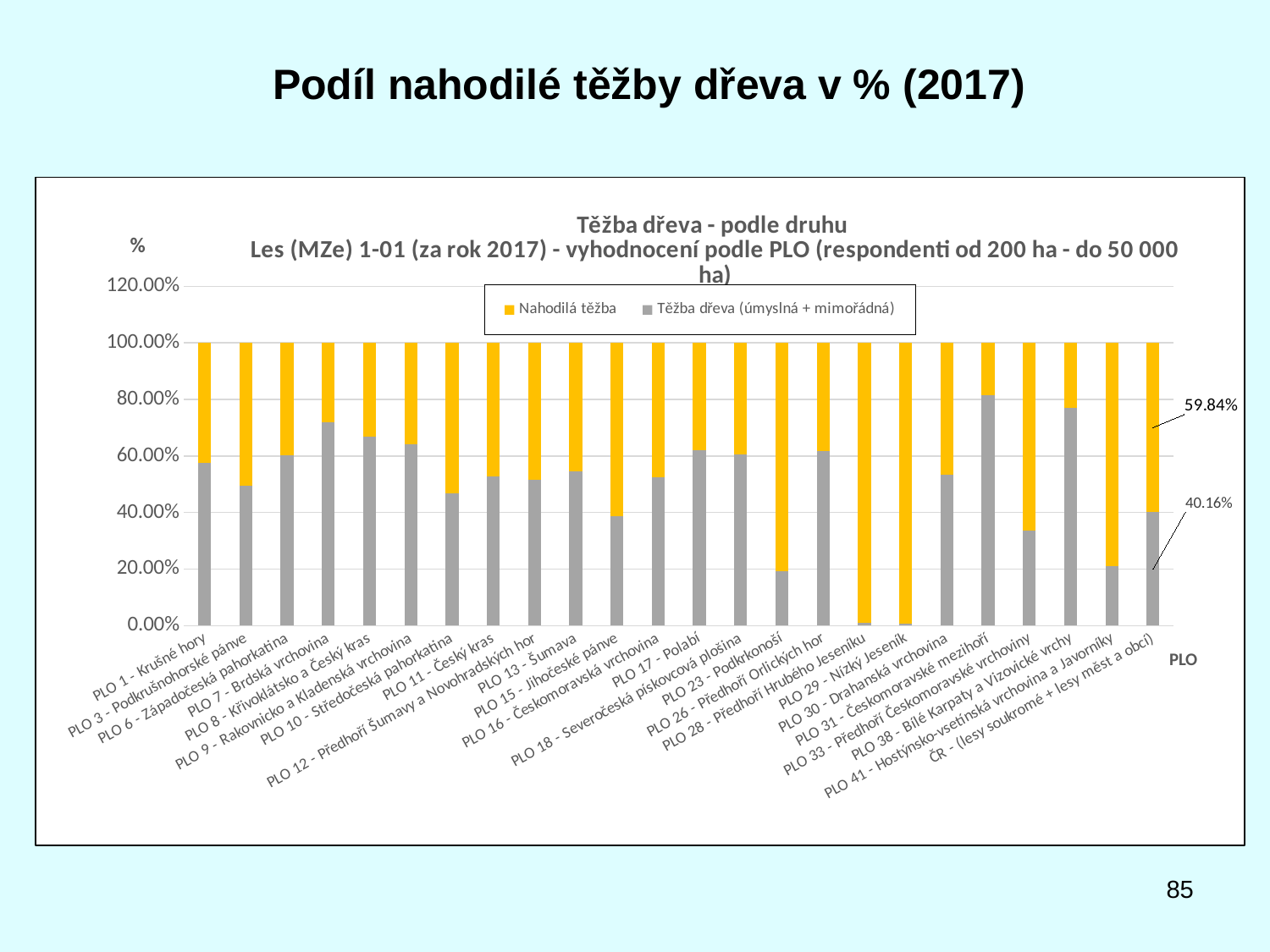
Which has the larger Těžba dřeva (úmyslná + mimořádná) share: PLO 7 - Brdská vrchovina or PLO 38 - Bílé Karpaty a Vizovické vrchy? PLO 38 - Bílé Karpaty a Vizovické vrchy Is the Nahodilá těžba share for PLO 29 - Nízký Jeseník greater or less than 80.00%? greater What is the value of Těžba dřeva (úmyslná + mimořádná) for ČR - (lesy soukromé + lesy měst a obcí)? 40.16% What is the title shown at the top of the slide? Podíl nahodilé těžby dřeva v % (2017) What type of chart is shown on the slide? stacked bar chart How many series does the chart legend list? 2 What is the value of Nahodilá těžba for ČR - (lesy soukromé + lesy měst a obcí)? 59.84% Is the Těžba dřeva (úmyslná + mimořádná) value for PLO 7 - Brdská vrchovina greater or less than 60.00%? greater How many categories (bars) are plotted along the x axis? 24 Is the Těžba dřeva (úmyslná + mimořádná) value for PLO 38 - Bílé Karpaty a Vizovické vrchy greater or less than 40.00%? greater Which colour represents Nahodilá těžba in the chart? yellow What is the total of the stacked bar for ČR - (lesy soukromé + lesy měst a obcí)? 100.00%